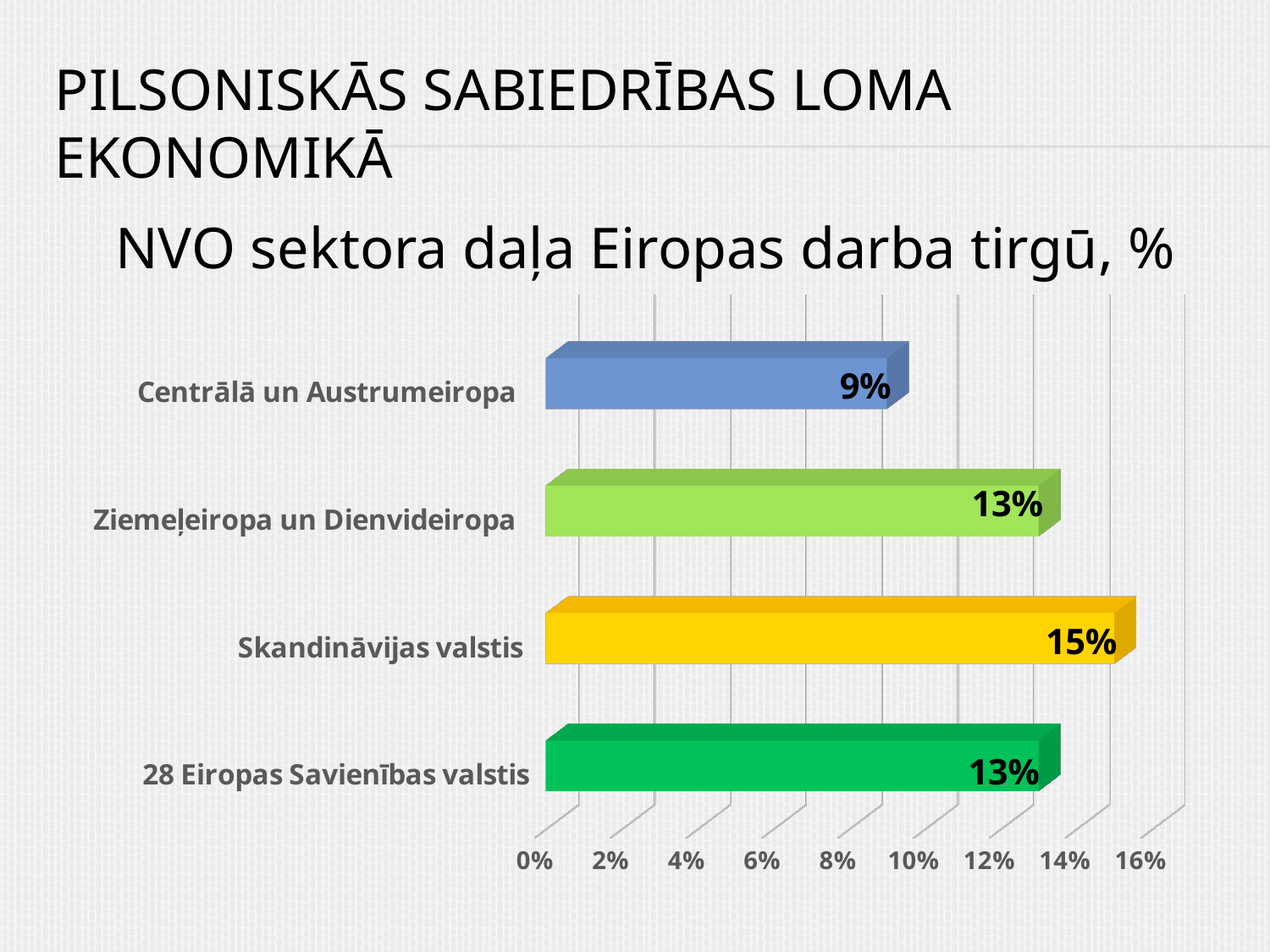
Which category has the highest value? Skandināvijas valstis What is the value for Ziemeļeiropa un Dienvideiropa? 13% What is the value for Skandināvijas valstis? 15% How many categories are shown in the chart? 4 Is the value for Centrālā un Austrumeiropa greater or less than 10%? less What is the title of the chart? NVO sektora daļa Eiropas darba tirgū, % What kind of chart is shown on the slide? bar chart What is the difference between the values for Skandināvijas valstis and Centrālā un Austrumeiropa? 6% What is the value for 28 Eiropas Savienības valstis? 13% Which is larger, the value for Skandināvijas valstis or the value for Ziemeļeiropa un Dienvideiropa? Skandināvijas valstis What is the value for Centrālā un Austrumeiropa? 9% Which category has the lowest value? Centrālā un Austrumeiropa